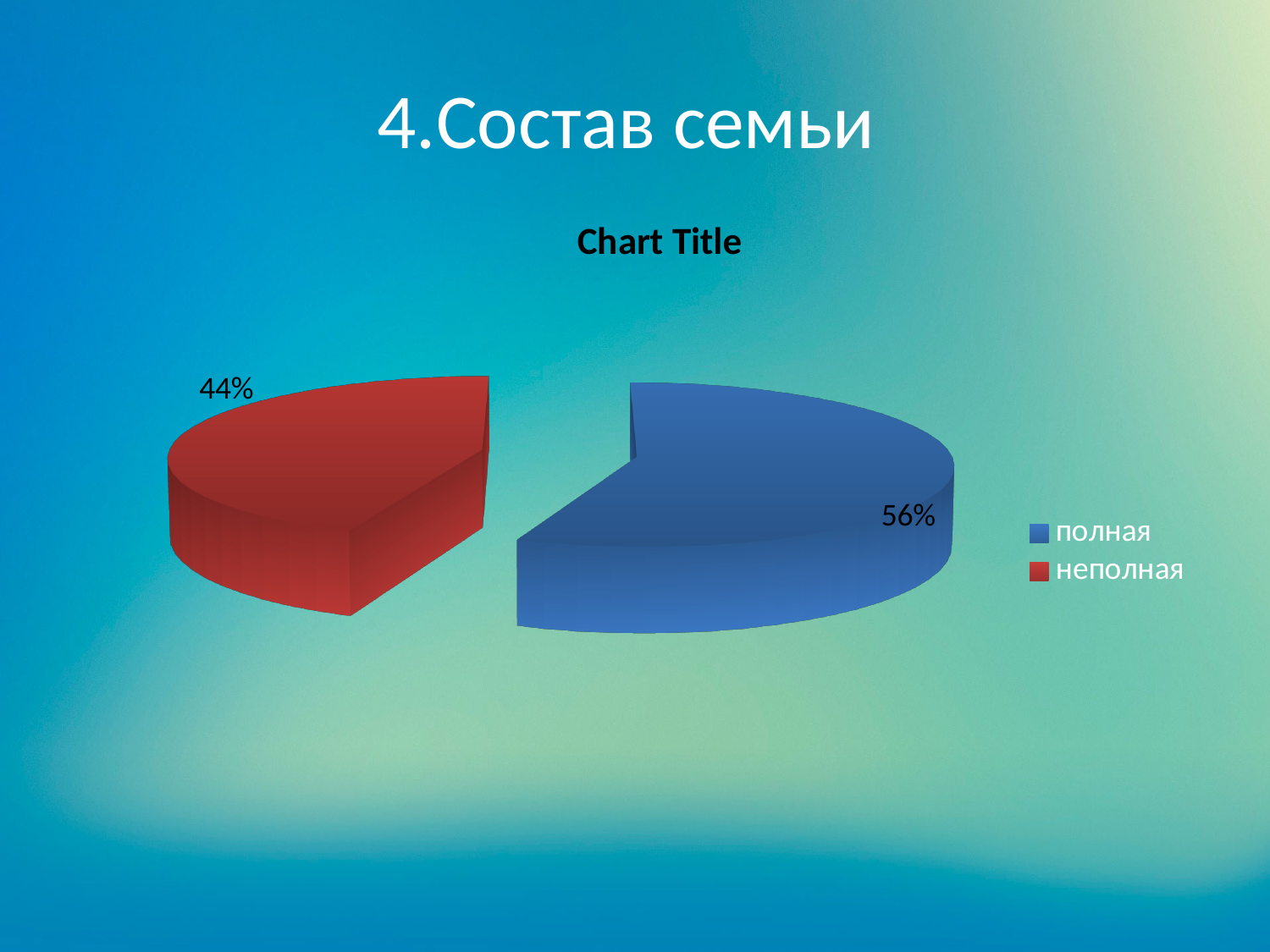
What share of the pie does полная have? 56% What kind of chart is shown on the slide? pie chart What is the title shown above the pie chart? Chart Title What share of the pie does неполная have? 44% Which is larger, полная or неполная? полная Which category has the smallest slice of the pie? неполная How many entries does the legend list? 2 How many slices does the pie chart have? 2 What is the difference in percentage points between полная and неполная? 12% Which category has the largest slice of the pie? полная What colour is the slice for неполная? red